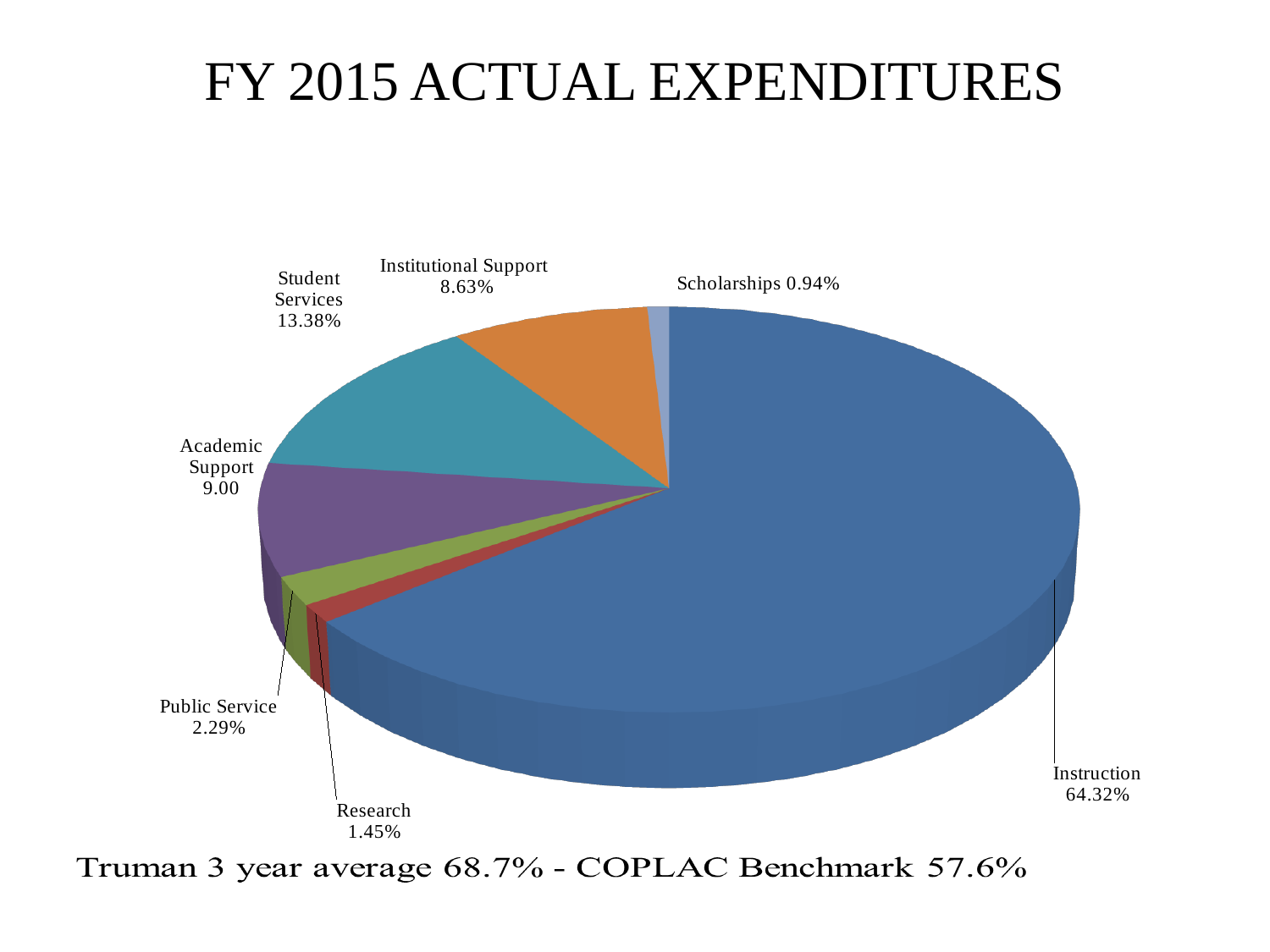
What kind of chart is shown on the slide? Pie chart Which category has the largest slice of the pie chart? Instruction What value is shown for Scholarships in the pie chart? 0.94% What value is shown for Institutional Support in the pie chart? 8.63% What value is shown for Research in the pie chart? 1.45% What share of FY 2015 actual expenditures is Student Services? 13.38% What share of FY 2015 actual expenditures is Instruction? 64.32% How many slices does the pie chart have? 7 What is the difference between the Student Services share and the Institutional Support share? 4.75% Which is larger, Public Service or Research? Public Service What is the title of the chart on the slide? FY 2015 ACTUAL EXPENDITURES Which category has the smallest slice of the pie chart? Scholarships